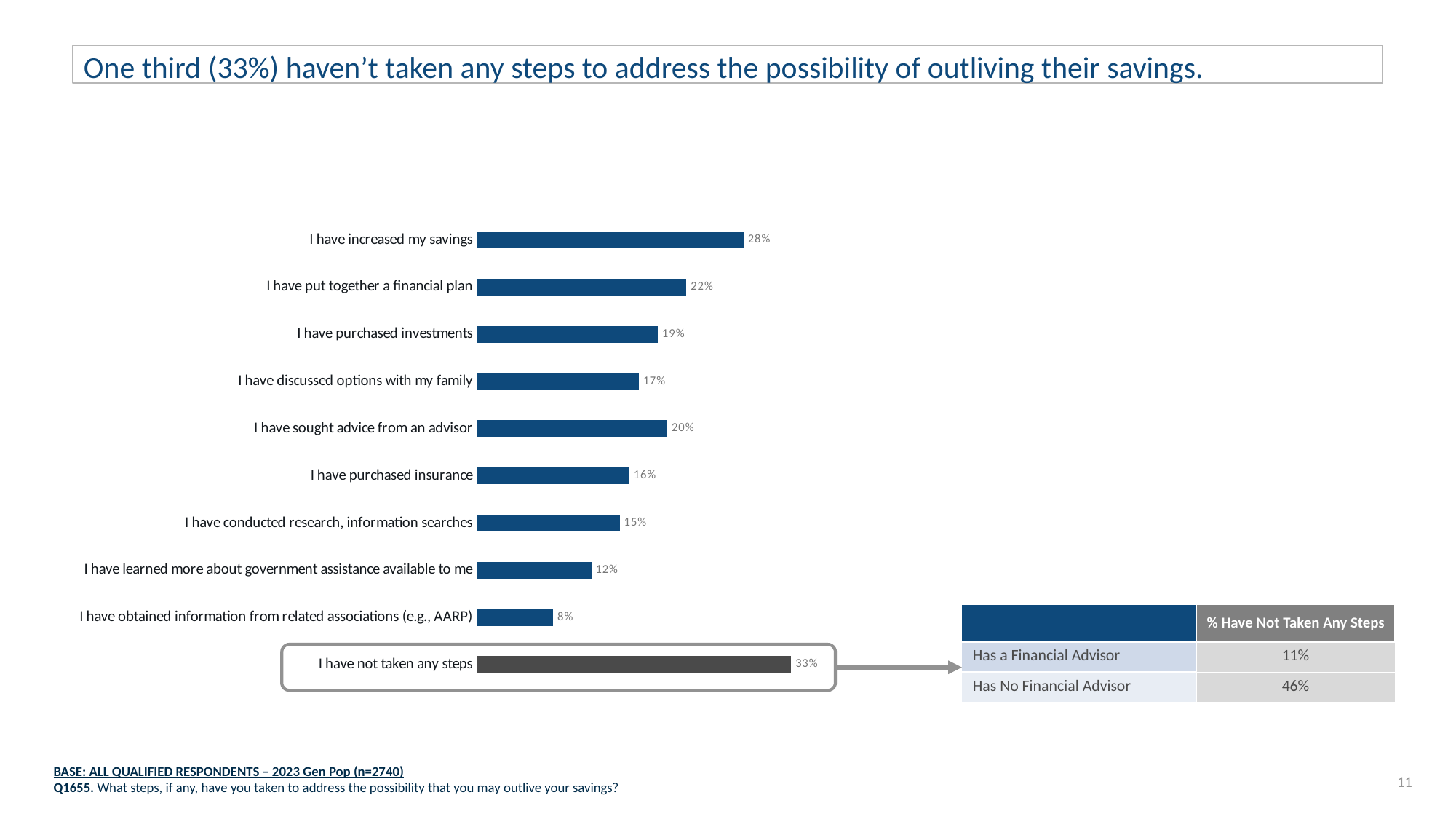
How many categories are shown in the bar chart? 10 Which category has the lowest value in the chart? I have obtained information from related associations (e.g., AARP) What type of chart is shown on the slide? Bar chart What percentage of respondents said they have increased their savings? 28% Which category has the highest value in the chart? I have not taken any steps According to the table, what percentage of those with no financial advisor have not taken any steps? 46% Which is larger: "I have purchased investments" or "I have discussed options with my family"? I have purchased investments What is the value for "I have sought advice from an advisor"? 20% Which bar is shown in a different colour (dark grey) from the others? I have not taken any steps What percentage of respondents have obtained information from related associations (e.g., AARP)? 8% What is the difference between "I have not taken any steps" and "I have increased my savings"? 5% What is the difference between "I have put together a financial plan" and "I have purchased insurance"? 6%